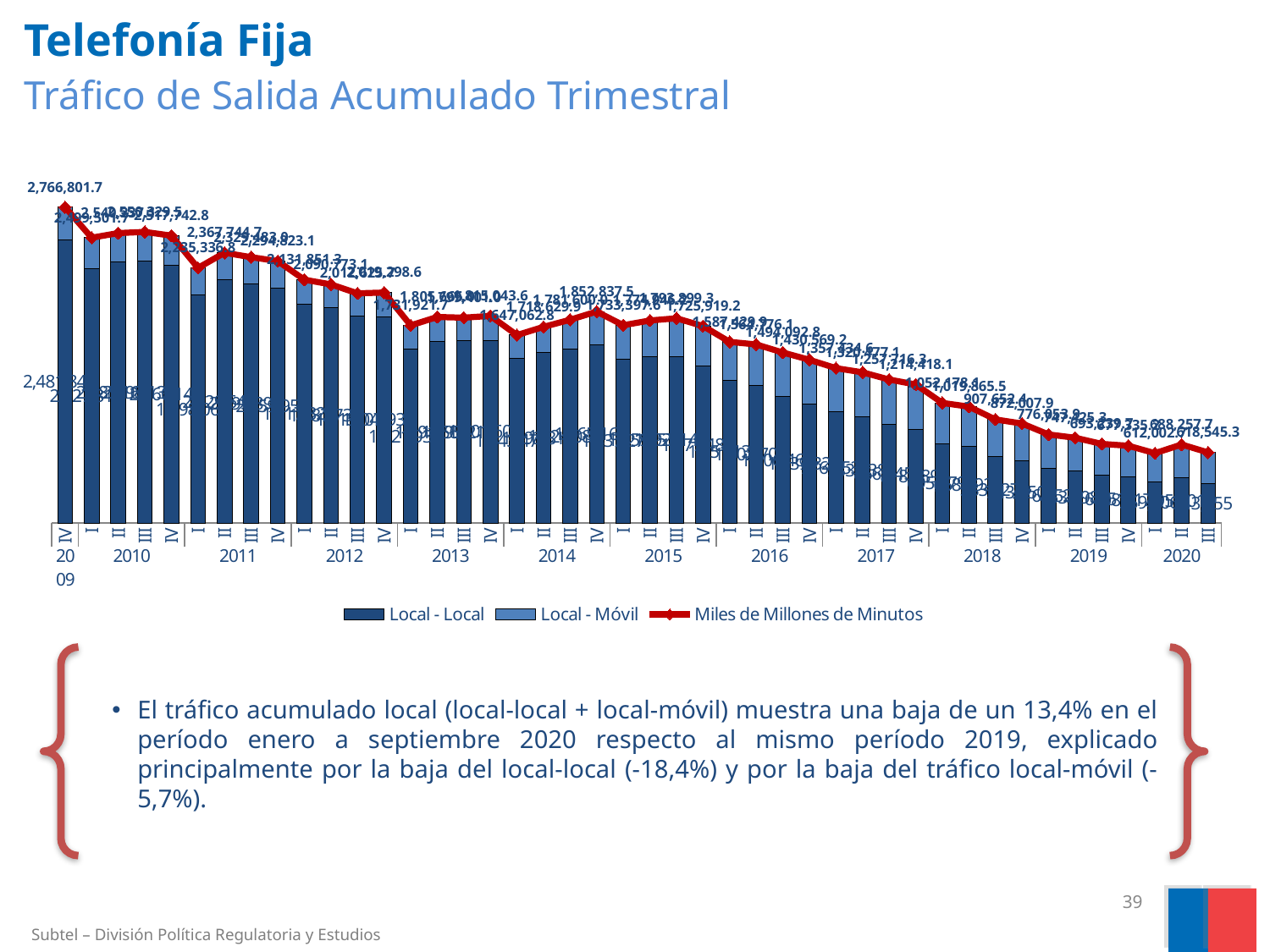
In 2009 IV, which segment is larger, Local - Local or Local - Móvil? Local - Local How many series does the legend list? 3 Which is larger, the total stacked bar for 2015 I or for 2018 I? 2015 I What is the value of the Miles de Millones de Minutos line for 2009 IV? 2,766,801.7 Does the Miles de Millones de Minutos line rise or fall from 2009 to 2020? Falls In which quarter is the Miles de Millones de Minutos line at its highest? 2009 IV How many years are labelled along the x axis? 12 What is the subtitle of the chart on the slide? Tráfico de Salida Acumulado Trimestral What kind of chart is shown on the slide? A combination of a stacked bar chart and a line chart What are the legend entries of the chart? Local - Local, Local - Móvil, Miles de Millones de Minutos Which is larger, the Miles de Millones de Minutos value for 2010 I or for 2020 III? 2010 I